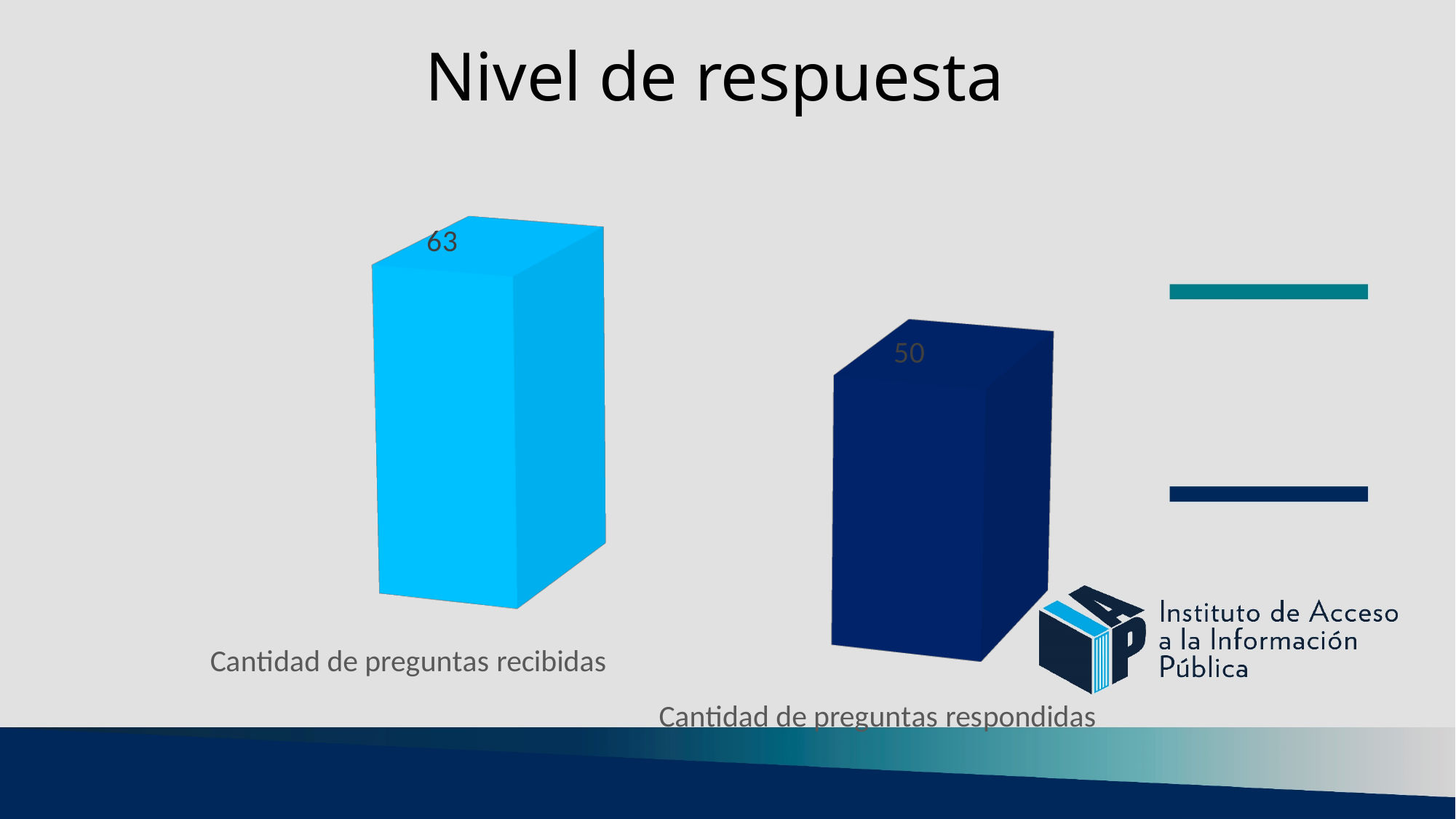
What is the value for 'Cantidad de preguntas recibidas'? 63 What kind of chart is shown on the slide? Bar chart How many categories are shown in the chart? 2 What is the value for 'Cantidad de preguntas respondidas'? 50 Which category has the highest value? Cantidad de preguntas recibidas What is the difference between the value for 'Cantidad de preguntas recibidas' and 'Cantidad de preguntas respondidas'? 13 Which category has the lowest value? Cantidad de preguntas respondidas Which is larger: the value for 'Cantidad de preguntas recibidas' or 'Cantidad de preguntas respondidas'? Cantidad de preguntas recibidas What is the title of the slide? Nivel de respuesta What colour is the bar for 'Cantidad de preguntas respondidas'? Dark blue